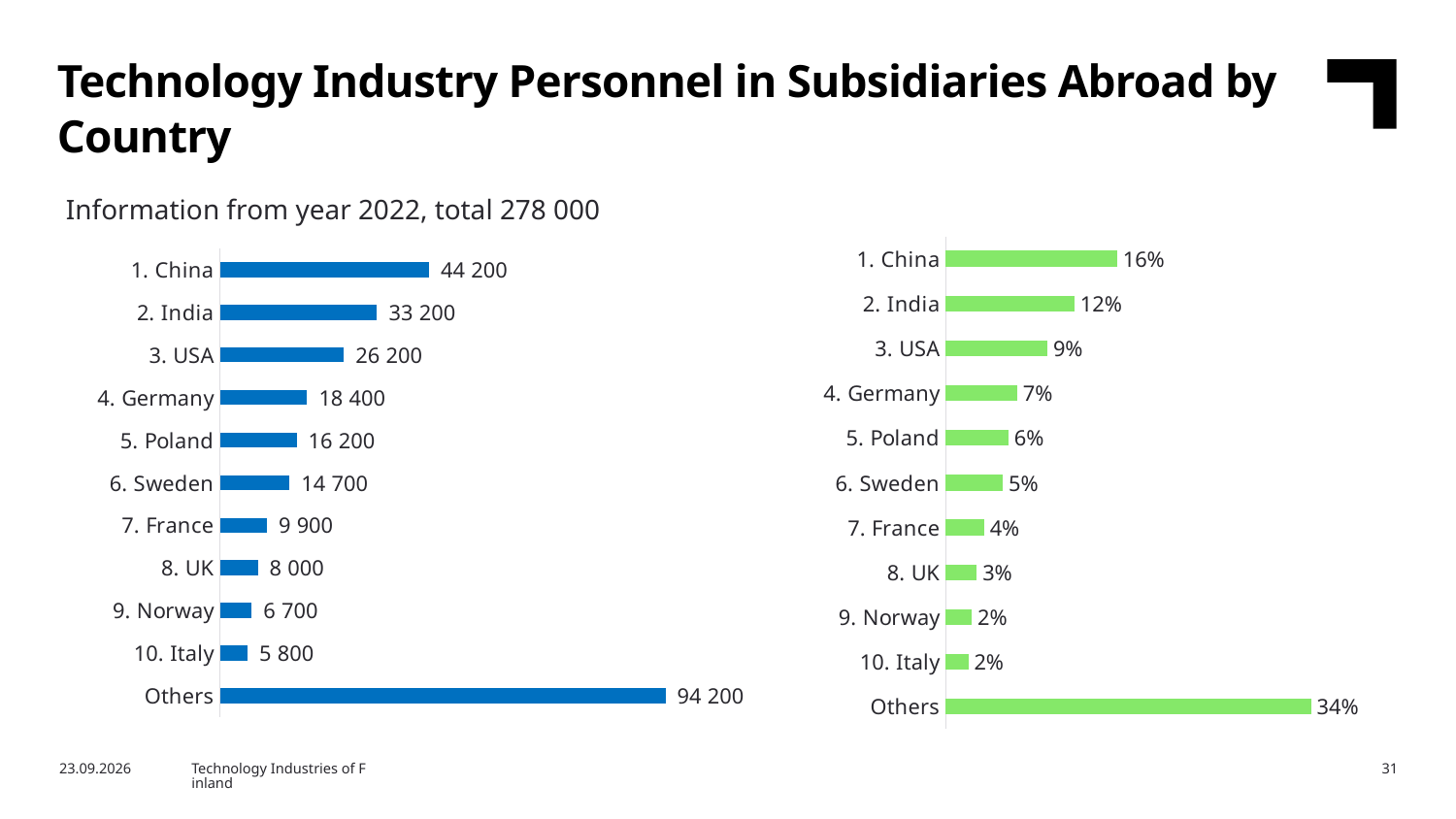
In the left chart, which category has the lowest value? 10. Italy In the right chart, what is the difference between the percentages for 1. China and 4. Germany? 9% In the right chart, what percentage is shown for Others? 34% In the left chart, what is the difference between the values for 1. China and 2. India? 11 000 In the left chart, what is the value for 1. China? 44 200 In the left chart, which is larger, the value for 5. Poland or 7. France? 5. Poland How many categories are shown in the left chart? 11 In the left chart, what is the value for 6. Sweden? 14 700 What kind of chart is the right chart? Bar chart In the left chart, which category has the highest value? Others What total is stated in the subtitle above the charts? 278 000 In the right chart, what percentage is shown for 3. USA? 9%